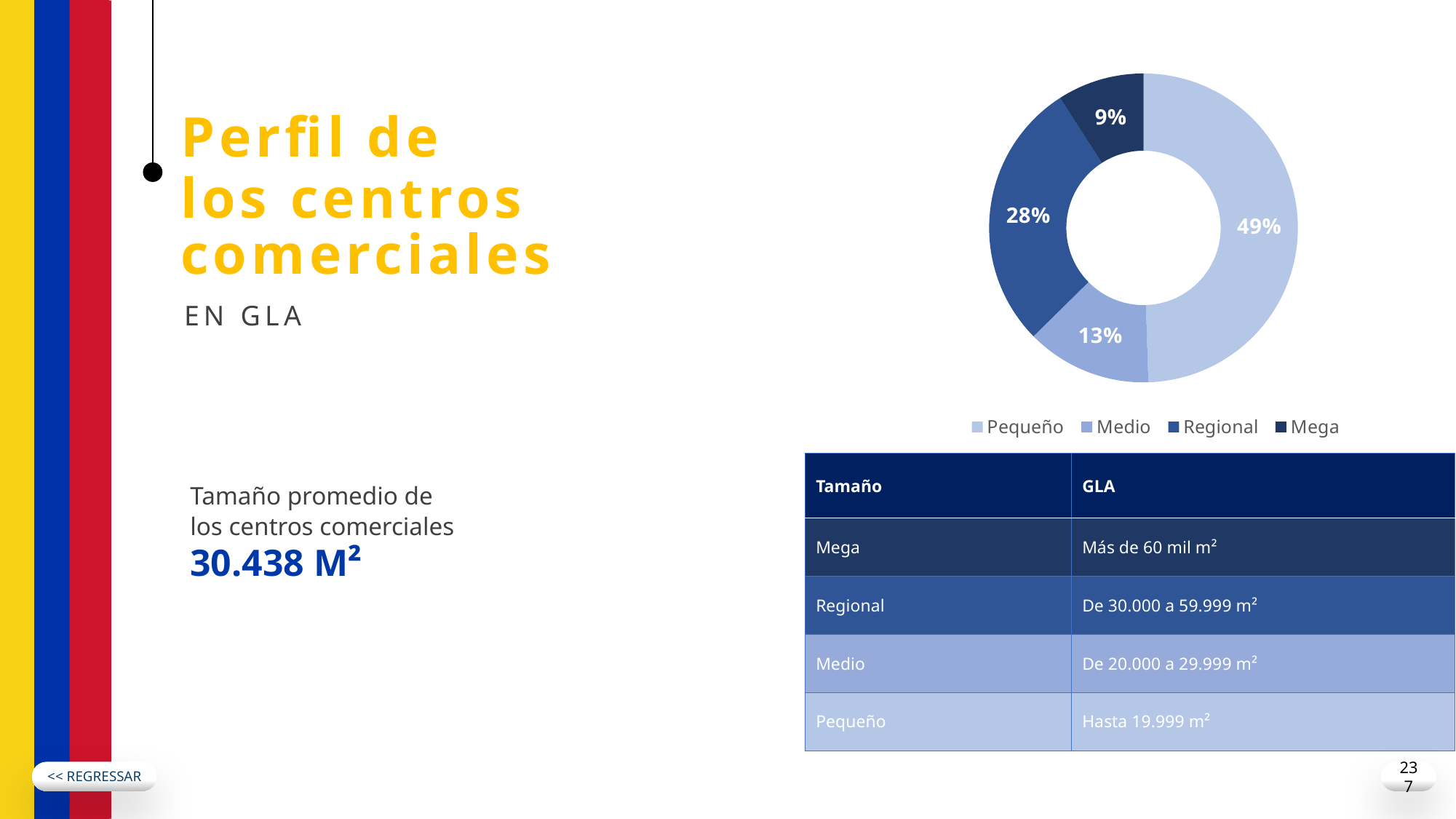
Which legend entry is shown in the darkest blue colour? Mega What share of the donut chart does Pequeño represent? 49% What kind of chart is shown on the slide? Donut (pie) chart What share of the donut chart does Medio represent? 13% What is the difference in percentage points between the Medio and Mega slices? 4 Which slice is larger, Regional or Medio? Regional Which category has the smallest slice in the donut chart? Mega Which category has the largest slice in the donut chart? Pequeño What is the difference in percentage points between the Pequeño and Regional slices? 21 How many categories are shown in the donut chart? 4 What share of the donut chart does Mega represent? 9% What share of the donut chart does Regional represent? 28%